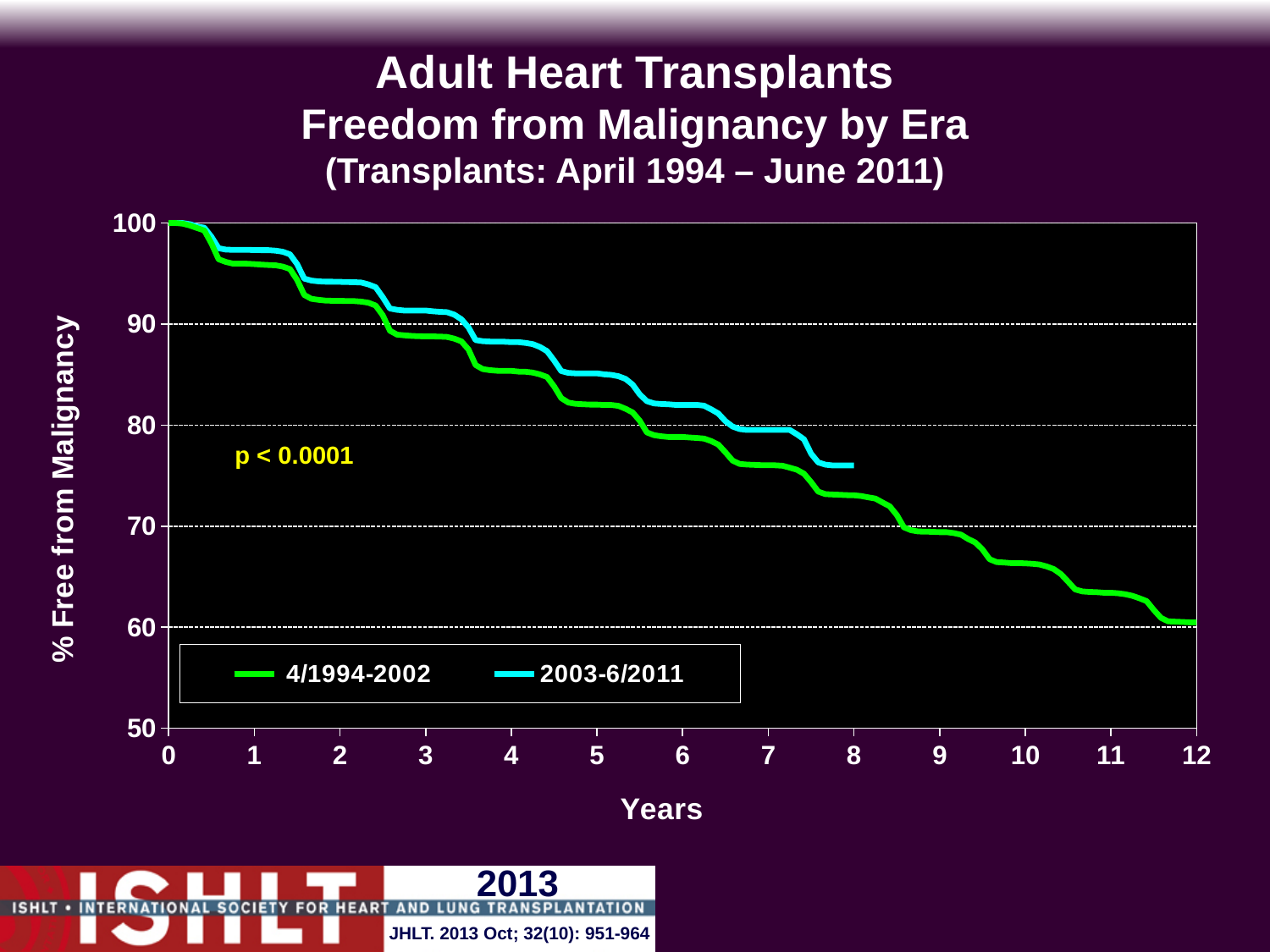
Which series extends further along the x axis, 4/1994-2002 or 2003-6/2011? 4/1994-2002 Is the value for the 2003-6/2011 series at year 2 greater or less than 90? greater What kind of chart is shown on the slide? line chart What p-value is printed on the chart? p < 0.0001 Is the value for the 2003-6/2011 series at year 8 greater or less than 70? greater How many series does the legend list? 2 Which series is plotted in green? 4/1994-2002 Is the value for the 4/1994-2002 series at year 10 greater or less than 70? less Do the values for the 4/1994-2002 series rise or fall as years increase? fall At year 6, which series has the higher % free from malignancy, 4/1994-2002 or 2003-6/2011? 2003-6/2011